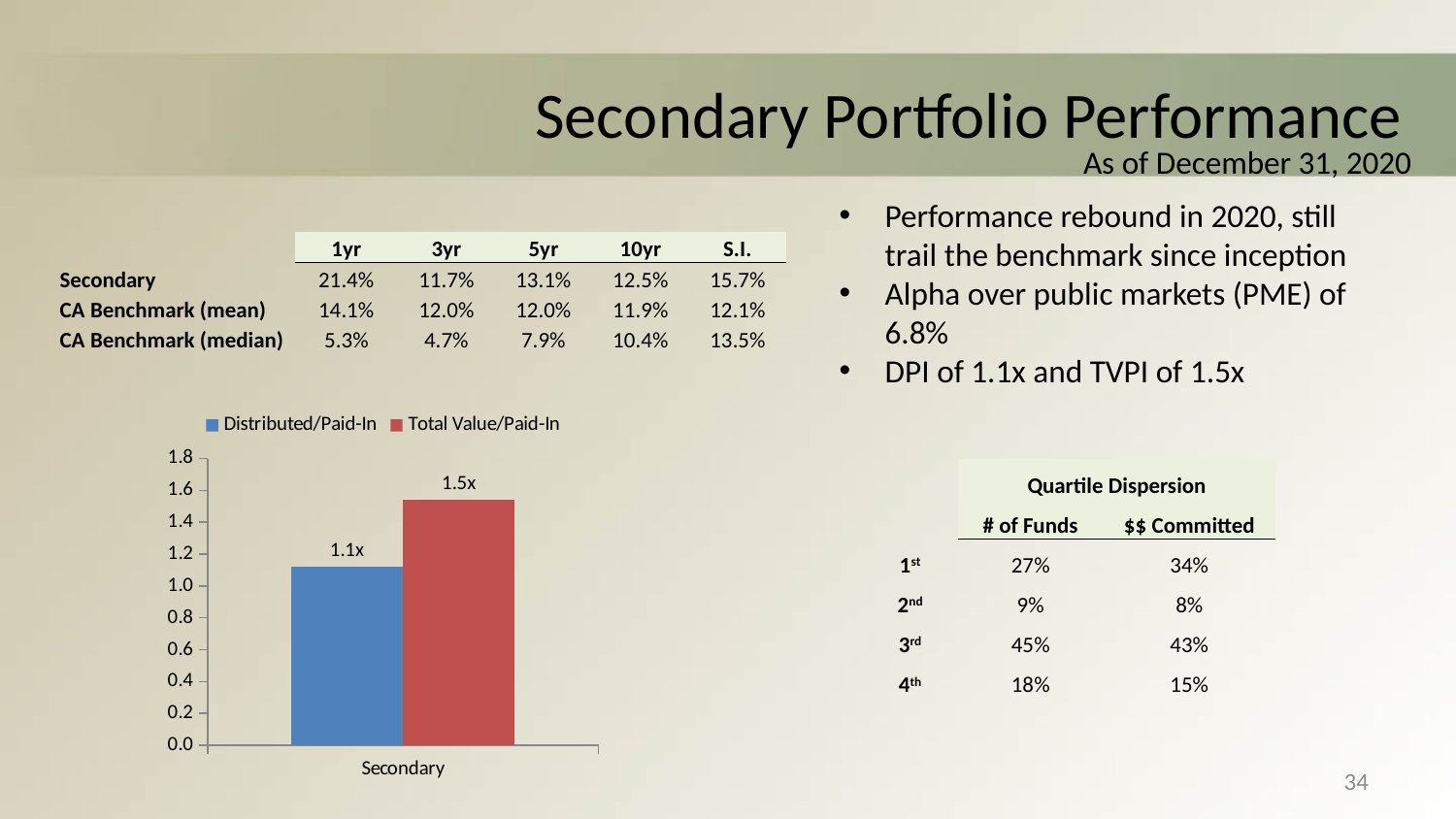
What kind of chart is shown on the slide? Bar chart What is the difference between the Total Value/Paid-In and Distributed/Paid-In values? 0.4x Which series has the higher value in the bar chart, Distributed/Paid-In or Total Value/Paid-In? Total Value/Paid-In What is the value of the Distributed/Paid-In bar for Secondary? 1.1x How many categories are shown on the x axis of the chart? 1 What is the category label on the x axis of the chart? Secondary How many series does the chart legend list? 2 What is the value of the Total Value/Paid-In bar for Secondary? 1.5x Which series has the highest bar in the chart? Total Value/Paid-In What colour is the Total Value/Paid-In bar in the chart? Red Which series has the lowest bar in the chart? Distributed/Paid-In Is the Distributed/Paid-In value greater or less than 1.0? greater